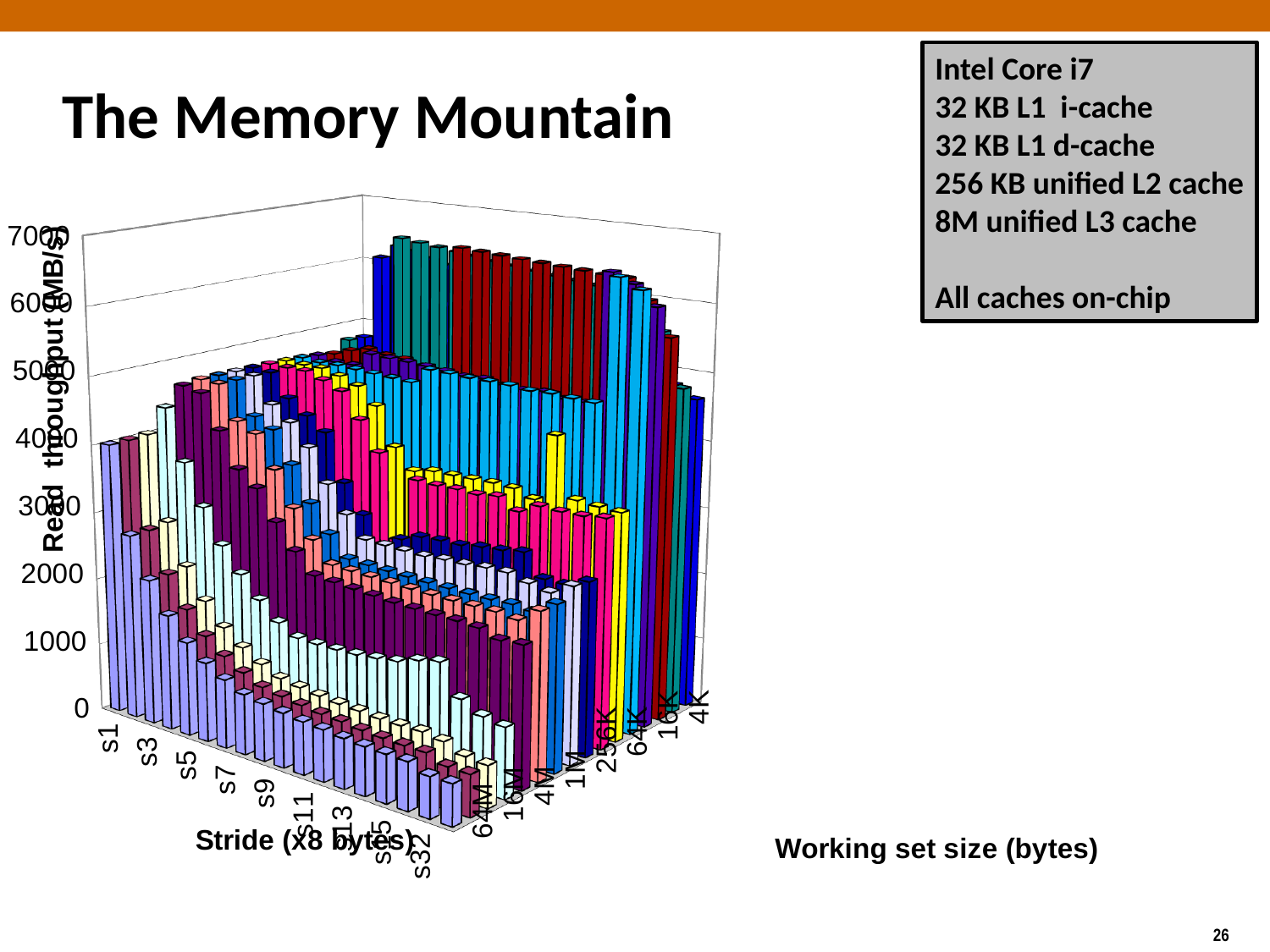
For a working set size of 64M, does read throughput rise or fall as the stride goes from s1 to s32? fall For stride s1, does read throughput rise or fall as the working set size goes from 64M to 4K? rise What kind of chart is shown on the slide? bar chart Which working set size has the higher read throughput at stride s1: 64M or 4K? 4K What is the highest tick value shown on the read throughput axis? 7000 What is the title of the chart? The Memory Mountain What is the label of the vertical axis of the chart? Read throughput (MB/s) How many working set size labels are shown along the working set size axis? 8 Is the read throughput for stride s32 at a working set size of 64M greater or less than 2000? less Is the read throughput for stride s1 at a working set size of 64M greater or less than 2000? greater How many stride labels are shown along the stride axis? 9